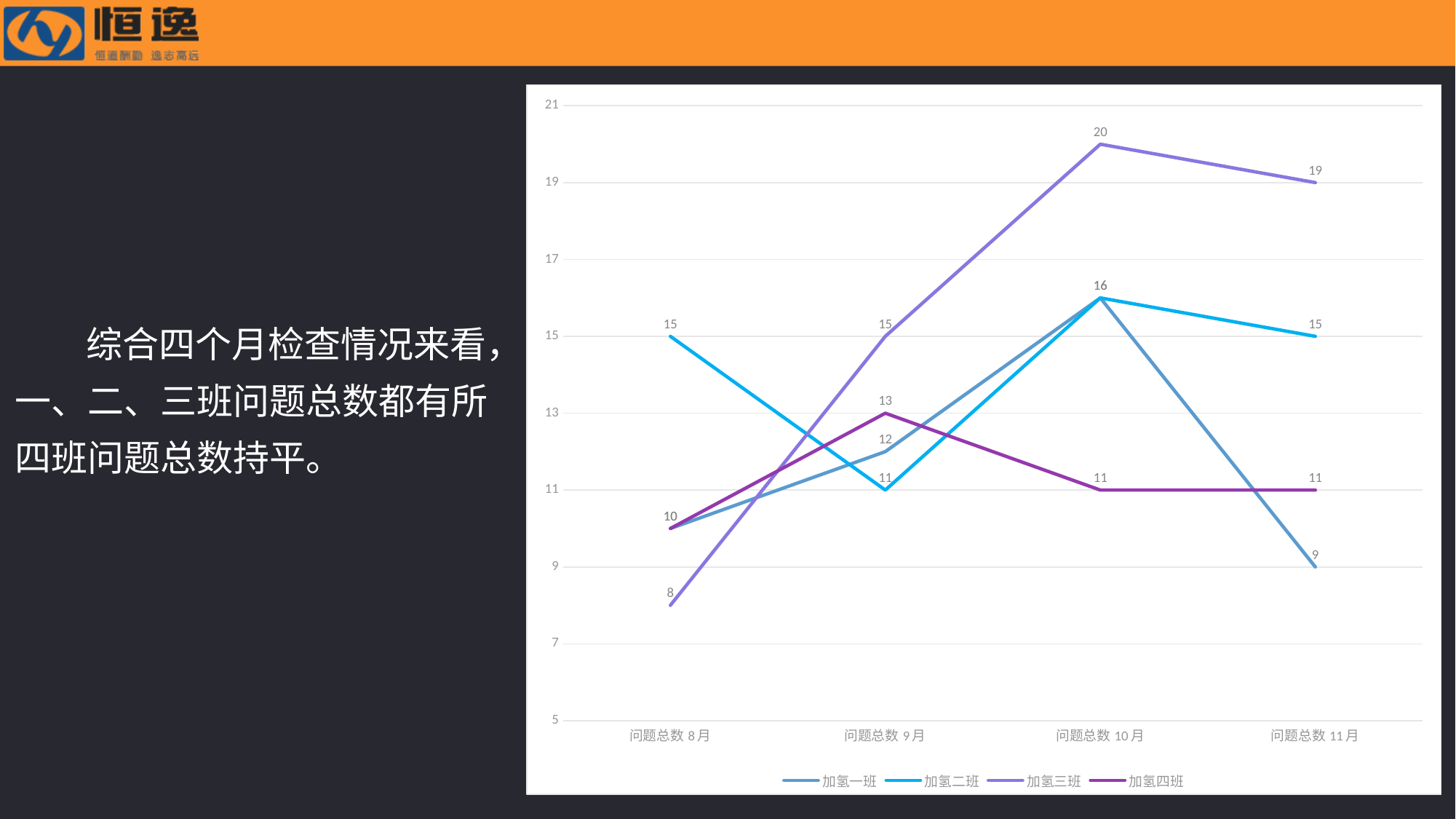
What is the value for 加氢一班 at 问题总数 11月? 9 How many series does the legend list? 4 What is the value for 加氢四班 at 问题总数 9月? 13 In which category does 加氢三班 have its lowest value? 问题总数 8月 What is the value for 加氢三班 at 问题总数 10月? 20 How many categories are shown on the x axis? 4 Which series has the highest value at 问题总数 10月? 加氢三班 What is the value for 加氢二班 at 问题总数 9月? 11 At 问题总数 11月, which is larger: 加氢二班 or 加氢四班? 加氢二班 What kind of chart is shown on the slide? line chart Does the 加氢三班 line rise or fall from 问题总数 8月 to 问题总数 10月? rise What is the difference between the 加氢三班 values at 问题总数 10月 and 问题总数 8月? 12